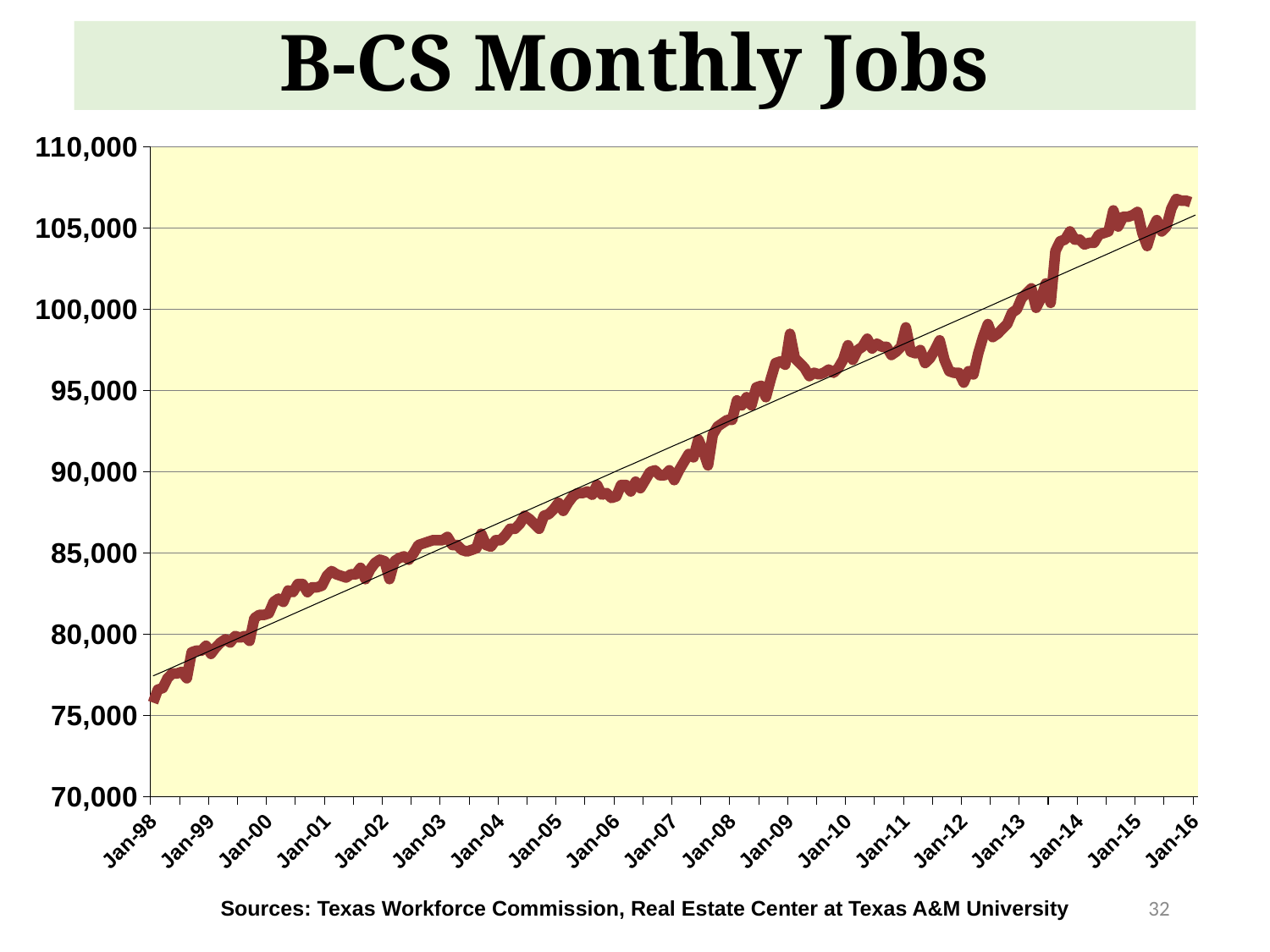
Is the value for Jan-16 greater or less than 105,000? greater What kind of chart is shown on the slide? line chart How many year labels are shown on the x axis? 19 What is the title of the chart? B-CS Monthly Jobs What is the highest value shown on the y axis? 110,000 Which is larger, the value for Jan-14 or the value for Jan-11? Jan-14 Is the value for Jan-04 greater or less than 90,000? less Is the value for Jan-12 greater or less than 100,000? less Do the monthly job values generally rise or fall from Jan-98 to Jan-16? rise Which is larger, the value for Jan-98 or the value for Jan-16? Jan-16